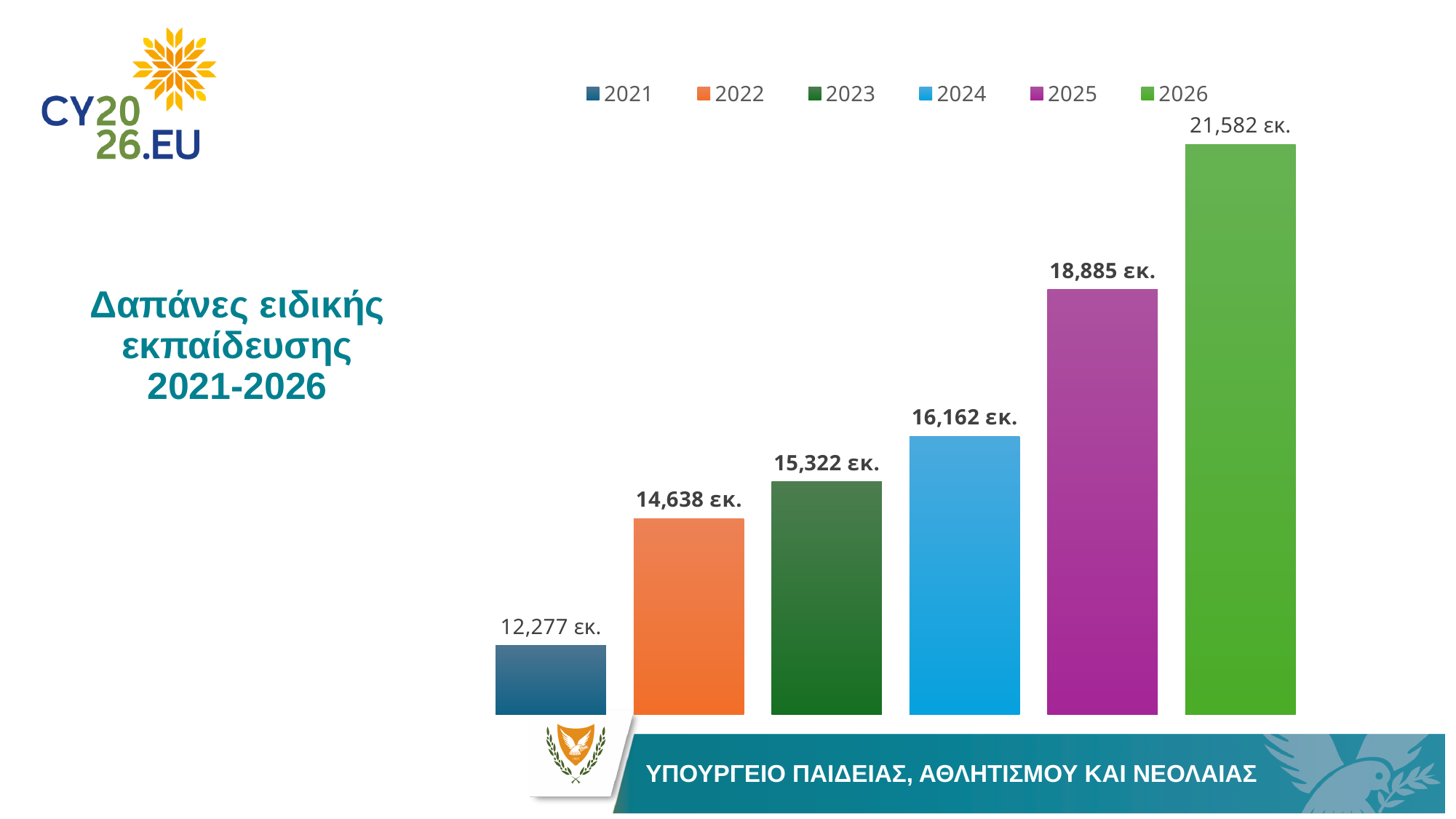
What is the value shown for 2026? 21,582 εκ. What is the difference between the values for 2025 and 2024? 2,723 εκ. What is the difference between the values for 2026 and 2021? 9,305 εκ. Which is larger, the value for 2023 or the value for 2022? 2023 Which year has the highest value? 2026 What kind of chart is shown on the slide? Bar chart What is the value shown for 2021? 12,277 εκ. What is the value shown for 2024? 16,162 εκ. How many entries does the legend list? 6 How many bars are plotted in the chart? 6 Which year has the lowest value? 2021 Do the values rise or fall from 2021 to 2026? Rise